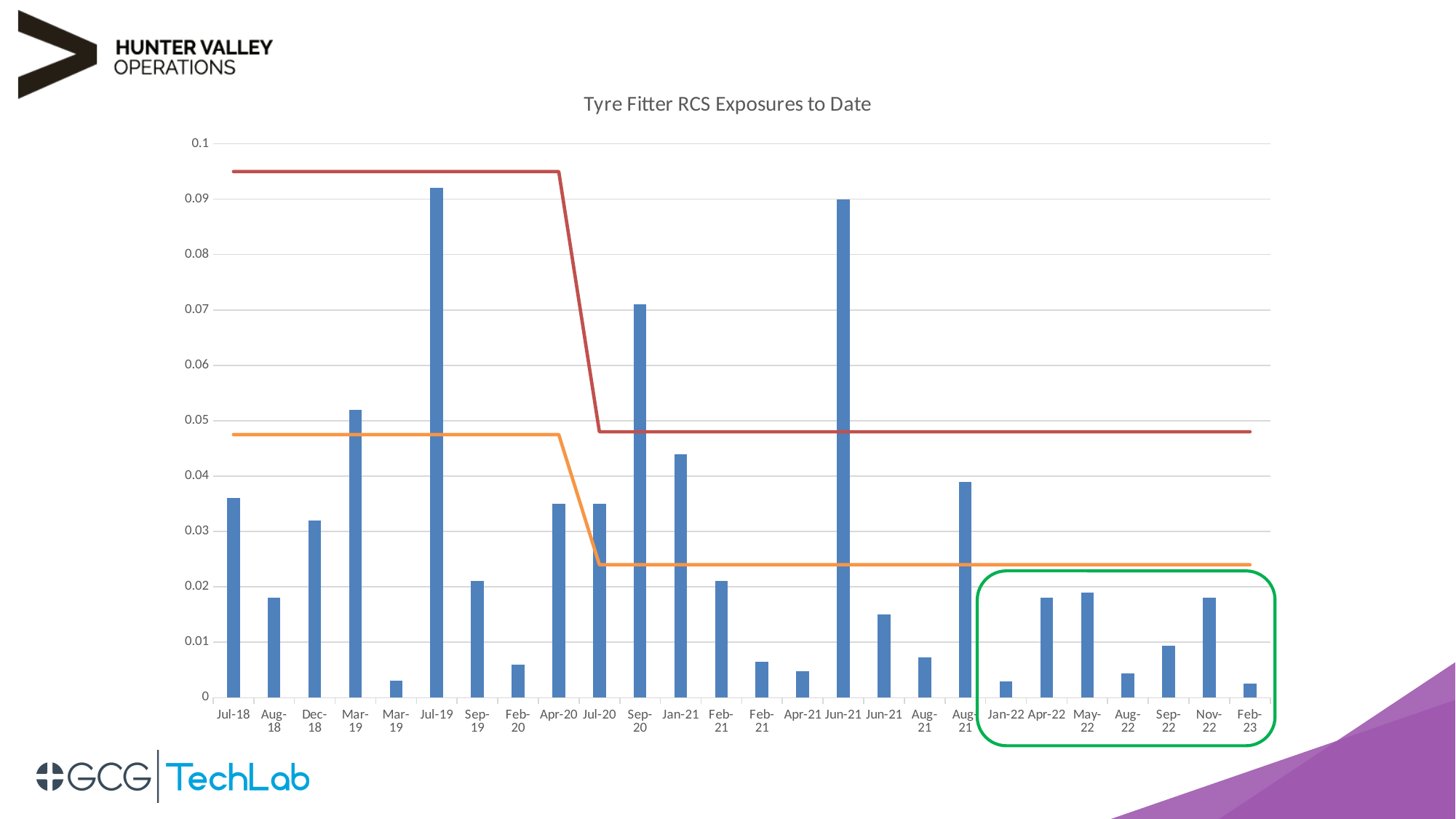
What kind of chart is used to show the exposure values? bar chart How many bars (categories) are plotted on the x axis? 26 Which has the larger value, Sep-20 or Jan-21? Sep-20 Which has the larger value, Jul-19 or Sep-19? Jul-19 Is the value for Jul-18 greater or less than 0.03? greater What is the title of the chart? Tyre Fitter RCS Exposures to Date Is the value for Jan-21 greater or less than 0.05? less Is the value for Feb-20 greater or less than 0.01? less What is the highest value shown on the y axis? 0.1 Which has the larger value, Dec-18 or Aug-18? Dec-18